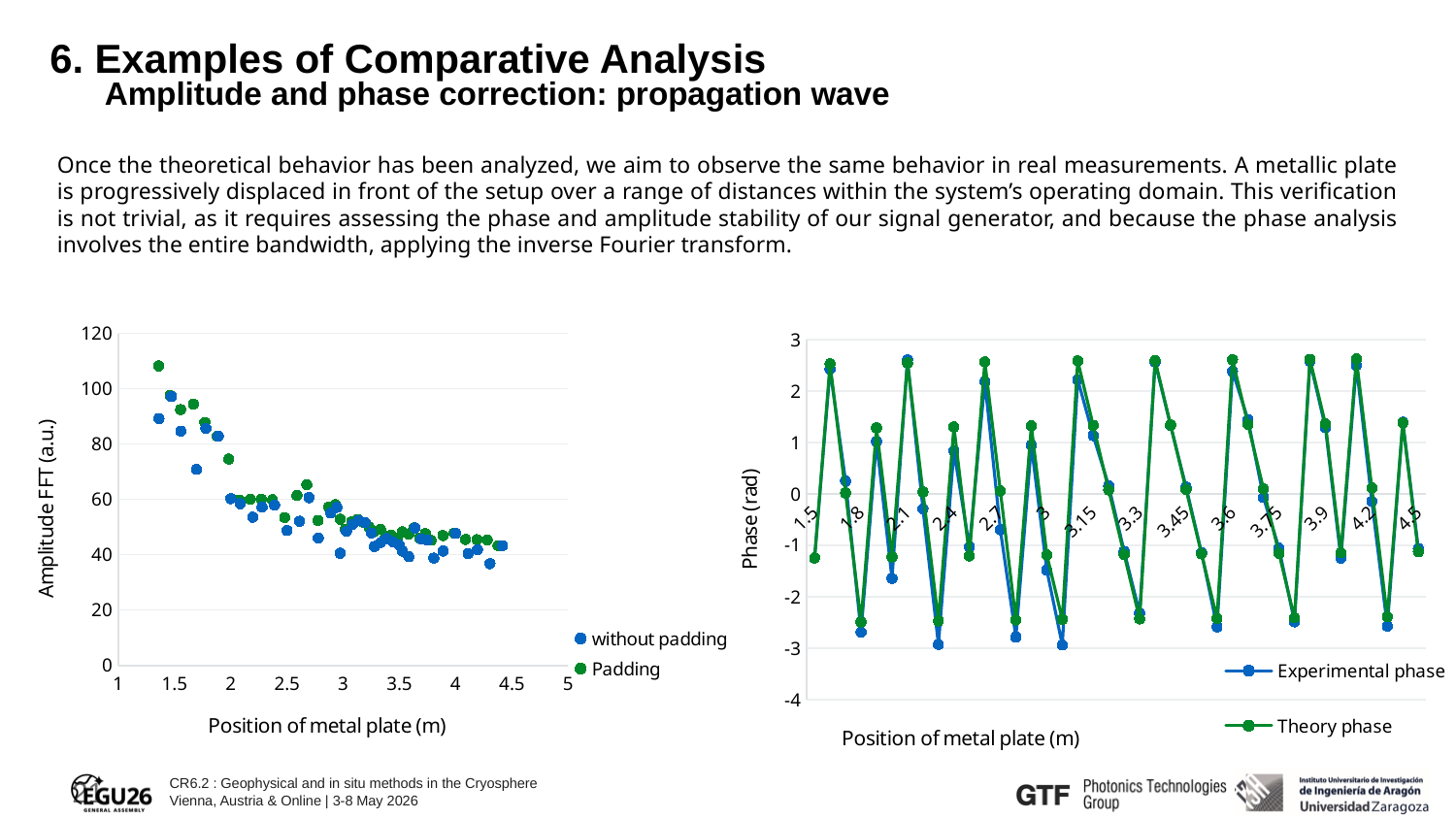
In the right chart, is the lowest value of the Experimental phase series greater or less than -2? less What are the two legend entries of the left chart? without padding, Padding What kind of chart is the left chart (Amplitude FFT vs position of metal plate)? scatter chart In the left chart, is the highest value of the Padding series greater or less than 100? greater In the left chart, are the values of both series near a position of 4.5 m greater or less than 60? less What is the y-axis title of the right chart? Phase (rad) In the left chart, do the amplitude values rise or fall as the position of the metal plate increases? fall What kind of chart is the right chart (Phase vs position of metal plate)? line chart How many series does the legend of the left chart list? 2 How many series does the legend of the right chart list? 2